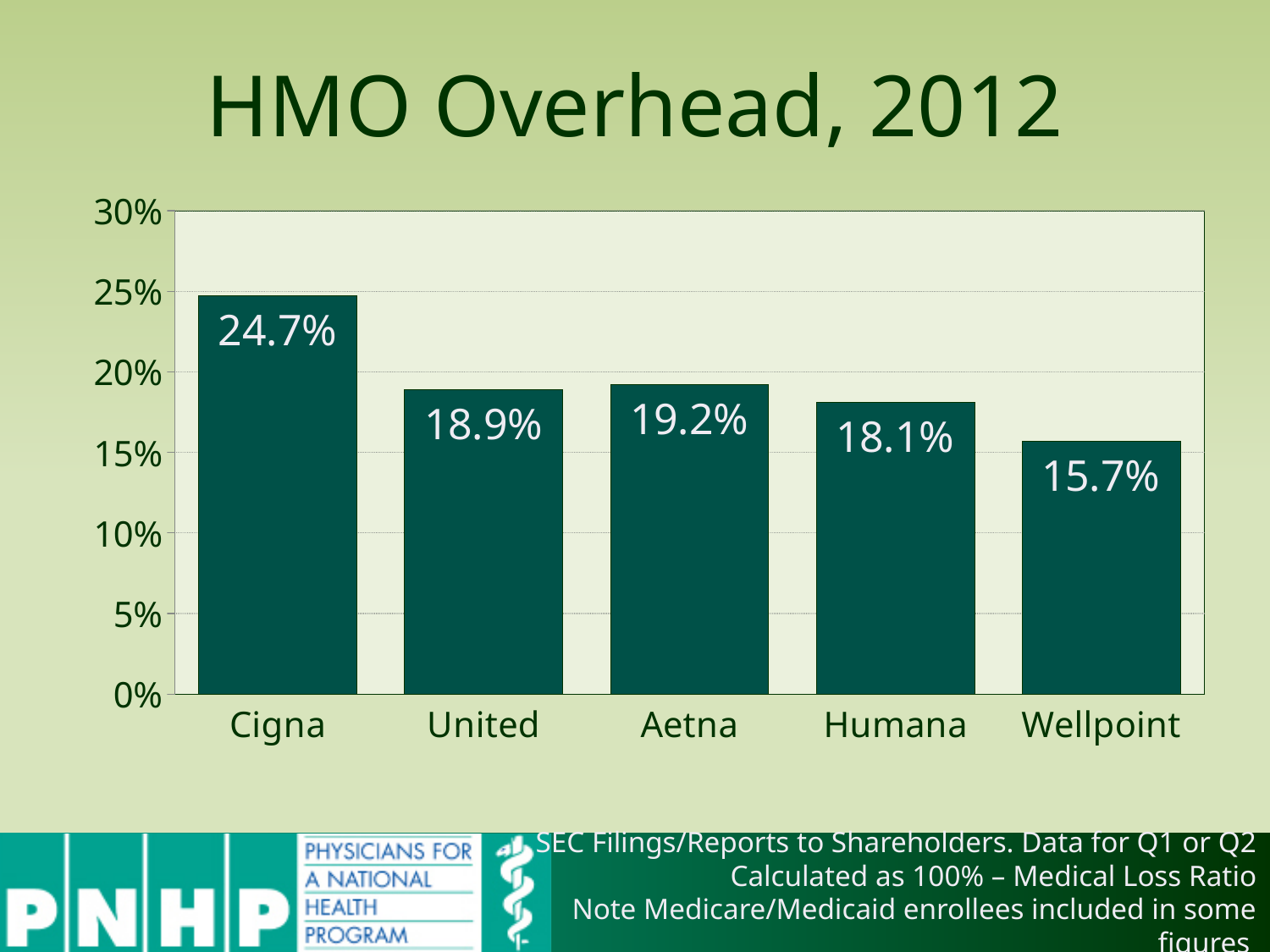
Which has a higher overhead, United or Humana? United What is the overhead value for Wellpoint? 15.7% Is the value for Cigna greater or less than 20%? greater What is the difference between Cigna's and Wellpoint's overhead? 9.0% What is the difference between Aetna's and United's overhead? 0.3% What is the title of the chart? HMO Overhead, 2012 Which HMO has the highest overhead? Cigna Which HMO has the lowest overhead? Wellpoint What is the overhead value for Humana? 18.1% What is the overhead value for Cigna? 24.7% How many HMOs are shown in the chart? 5 What kind of chart is shown on the slide? Bar chart